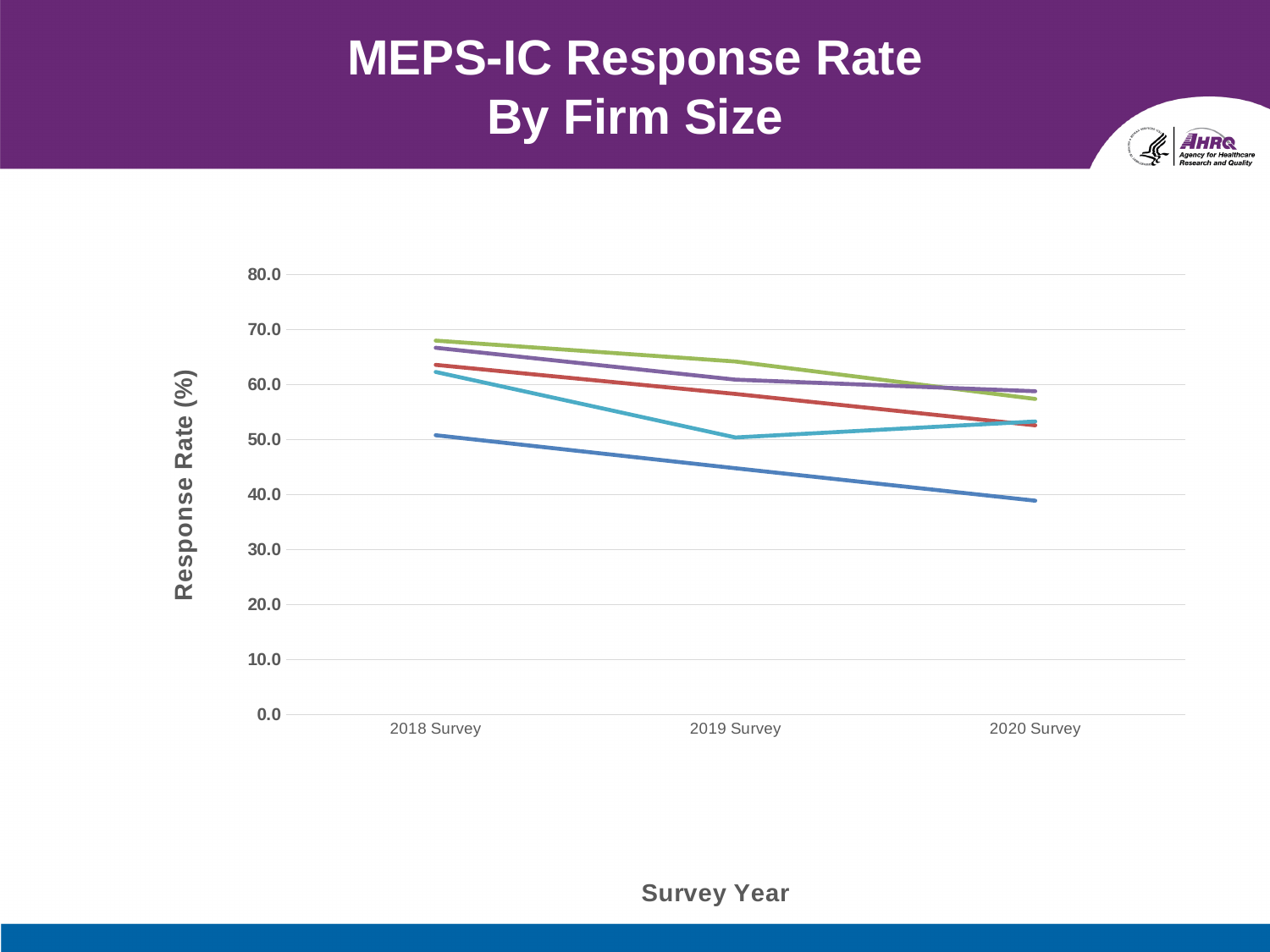
What kind of chart is shown on the slide? line chart How many survey years are shown on the x axis? 3 How many lines are plotted on the chart? 5 Which line has the lowest value at the 2020 Survey? the dark blue line Which line has the highest value at the 2018 Survey? the green line Is the value of the dark blue line at the 2019 Survey greater or less than 50.0? less Does the green line rise or fall from the 2018 Survey to the 2020 Survey? fall Is the value of the green line at the 2018 Survey greater or less than 70.0? less Does the dark blue line rise or fall from the 2018 Survey to the 2020 Survey? fall What is the label of the vertical axis? Response Rate (%) Is the value of the light blue line at the 2018 Survey greater or less than 60.0? greater What is the title of the chart on the slide? MEPS-IC Response Rate By Firm Size